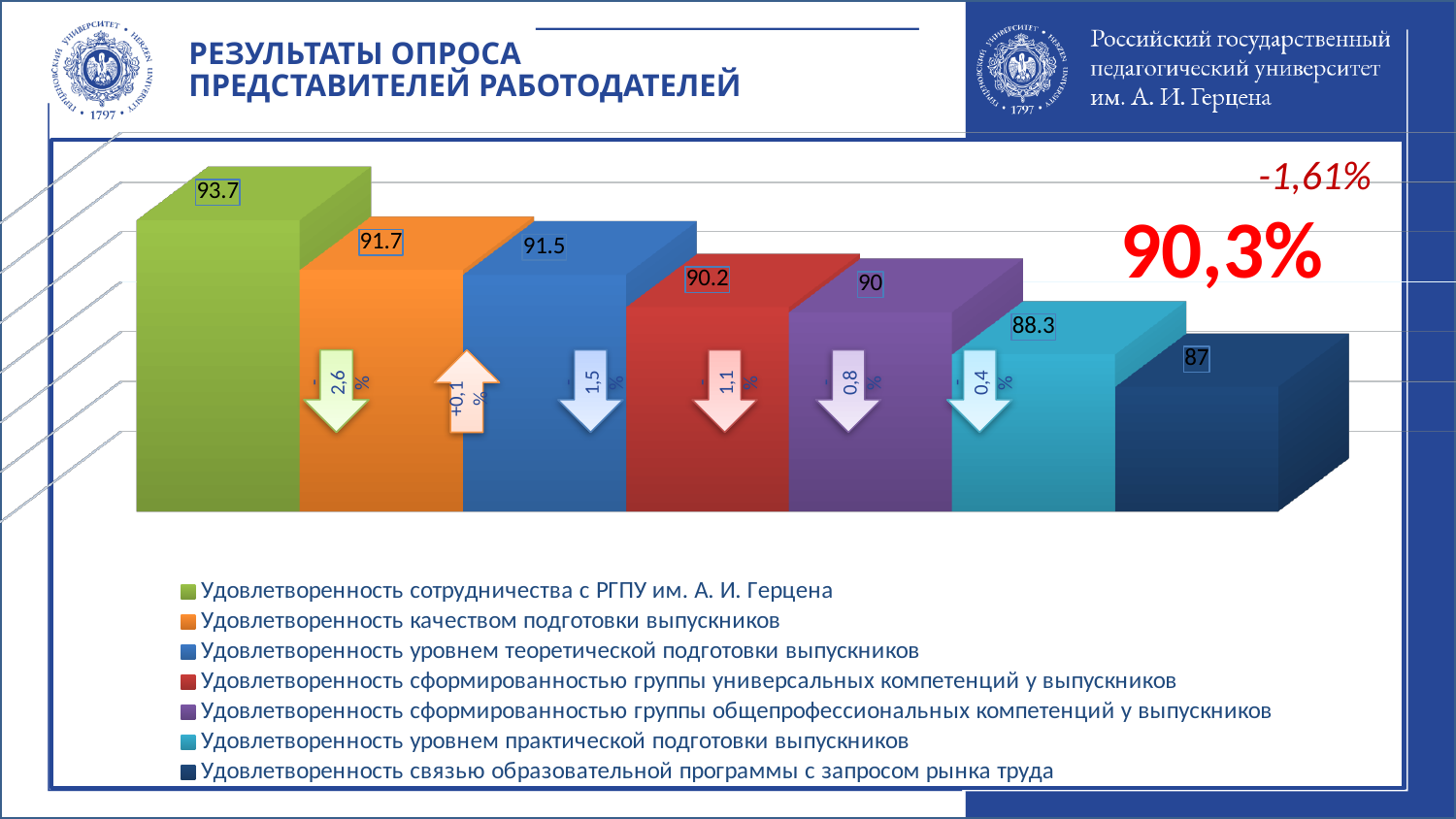
What is the difference between the highest value (93.7) and the lowest value (87)? 6.7 Which series has the lowest value? Удовлетворенность связью образовательной программы с запросом рынка труда What large percentage value is printed in red at the top right of the chart? 90,3% What value is shown for 'Удовлетворенность сотрудничества с РГПУ им. А. И. Герцена'? 93.7 Which series has the highest value? Удовлетворенность сотрудничества с РГПУ им. А. И. Герцена How many bars are plotted in the chart? 7 Which is larger: the value for 'Удовлетворенность уровнем теоретической подготовки выпускников' or the value for 'Удовлетворенность сформированностью группы универсальных компетенций у выпускников'? Удовлетворенность уровнем теоретической подготовки выпускников What kind of chart is shown on the slide? Bar chart What value is shown for 'Удовлетворенность качеством подготовки выпускников'? 91.7 What value is shown for 'Удовлетворенность связью образовательной программы с запросом рынка труда'? 87 How many series does the legend list? 7 What value is shown for 'Удовлетворенность уровнем практической подготовки выпускников'? 88.3